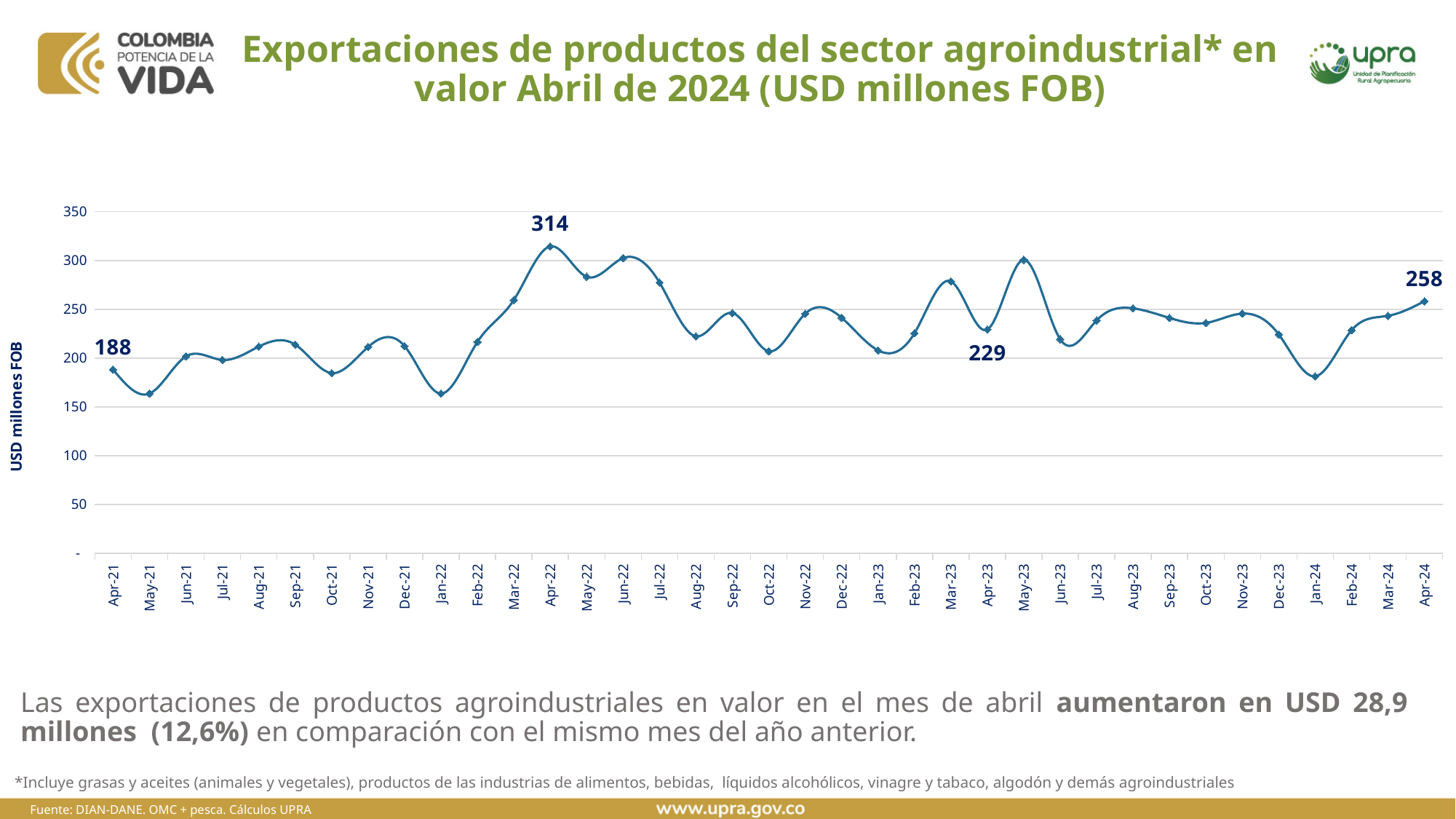
Which is larger, the value for Apr-24 or the value for Apr-23? Apr-24 What type of chart is shown on the slide? line chart What is the value for Apr-23? 229 What is the value for Apr-22? 314 What is the value for Apr-24? 258 What is the difference between the values for Apr-24 and Apr-23? 29 What is the value for Apr-21? 188 How many monthly data points are plotted on the chart? 37 Is the value for May-23 greater or less than 250? greater Which month has the highest value on the chart? Apr-22 What is the difference between the values for Apr-22 and Apr-21? 126 Is the value for Jan-24 greater or less than 200? less